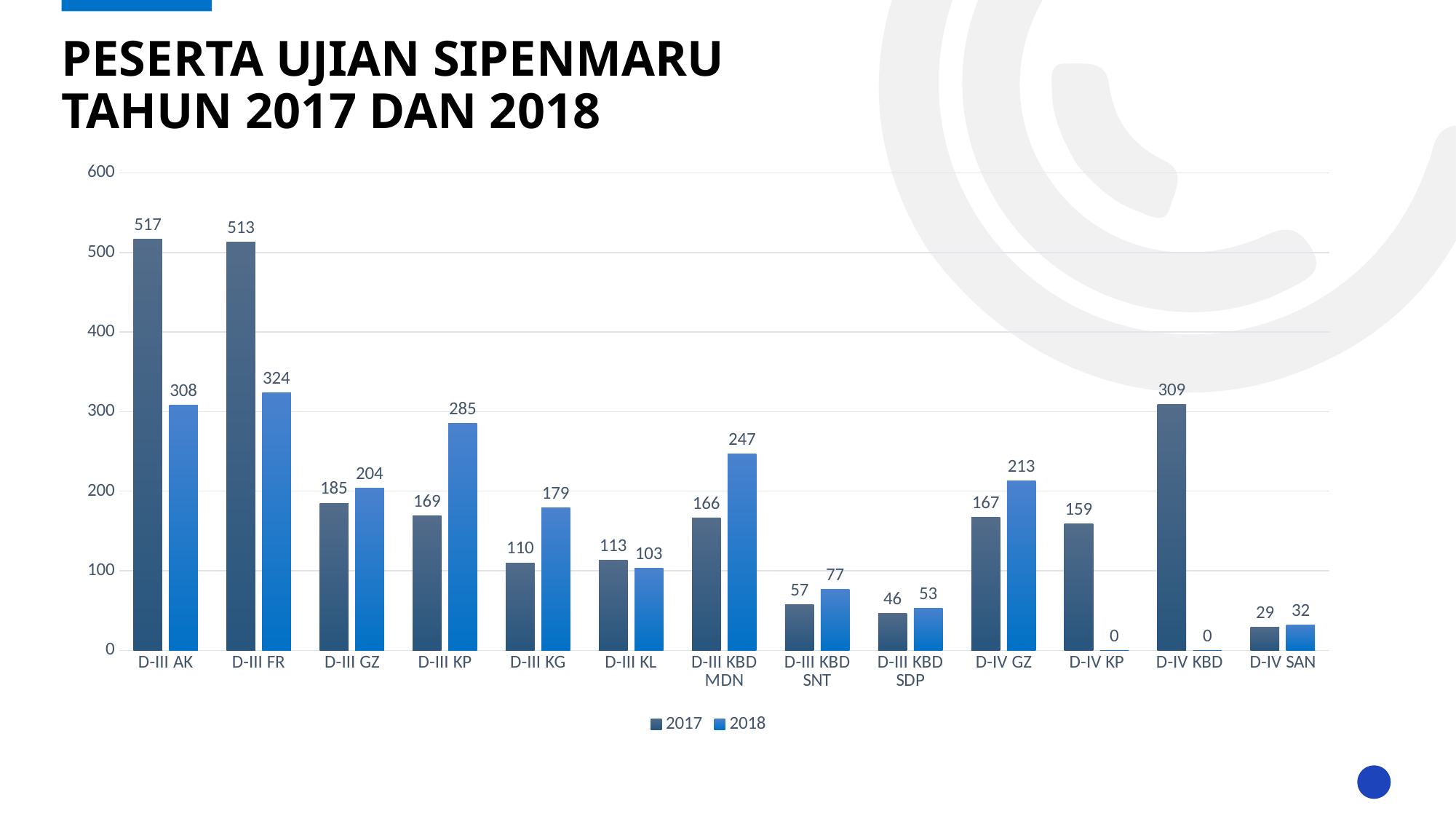
Which is larger for D-III KL: the 2017 value or the 2018 value? 2017 What is the difference between the 2017 and 2018 values for D-III AK? 209 What kind of chart is shown on the slide? Bar chart How many categories are shown on the x axis? 13 Which category has the highest value in the 2018 series? D-III FR What is the total of the 2017 and 2018 values for D-IV GZ? 380 What is the value for D-III AK in 2017? 517 What is the title of the slide? PESERTA UJIAN SIPENMARU TAHUN 2017 DAN 2018 Which category has the lowest value in the 2017 series? D-IV SAN What is the value for D-IV KP in 2018? 0 What is the value for D-III KBD MDN in 2018? 247 How many series does the legend list? 2